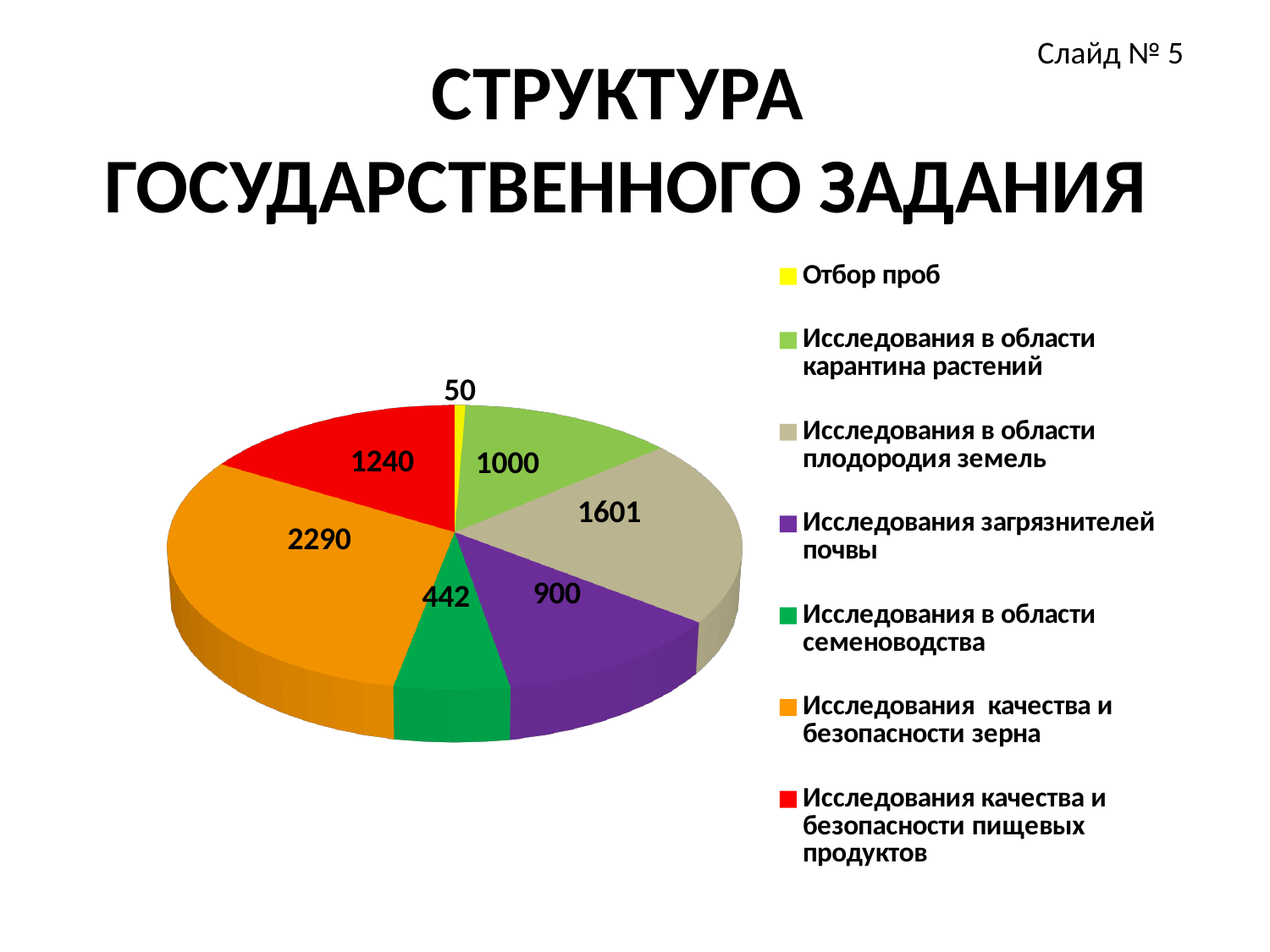
What is the value for Исследования качества и безопасности зерна? 2290 Which category has the largest value? Исследования качества и безопасности зерна What type of chart is shown on the slide? pie chart What is the total of all slices in the pie chart? 7523 What is the value for Отбор проб? 50 What is the difference between Исследования качества и безопасности зерна and Исследования в области плодородия земель? 689 What is the value for Исследования в области семеноводства? 442 Which is larger: Исследования загрязнителей почвы or Исследования качества и безопасности пищевых продуктов? Исследования качества и безопасности пищевых продуктов What is the value for Исследования в области плодородия земель? 1601 What colour is the slice for Исследования загрязнителей почвы? purple How many categories does the pie chart have? 7 Which category has the smallest value? Отбор проб